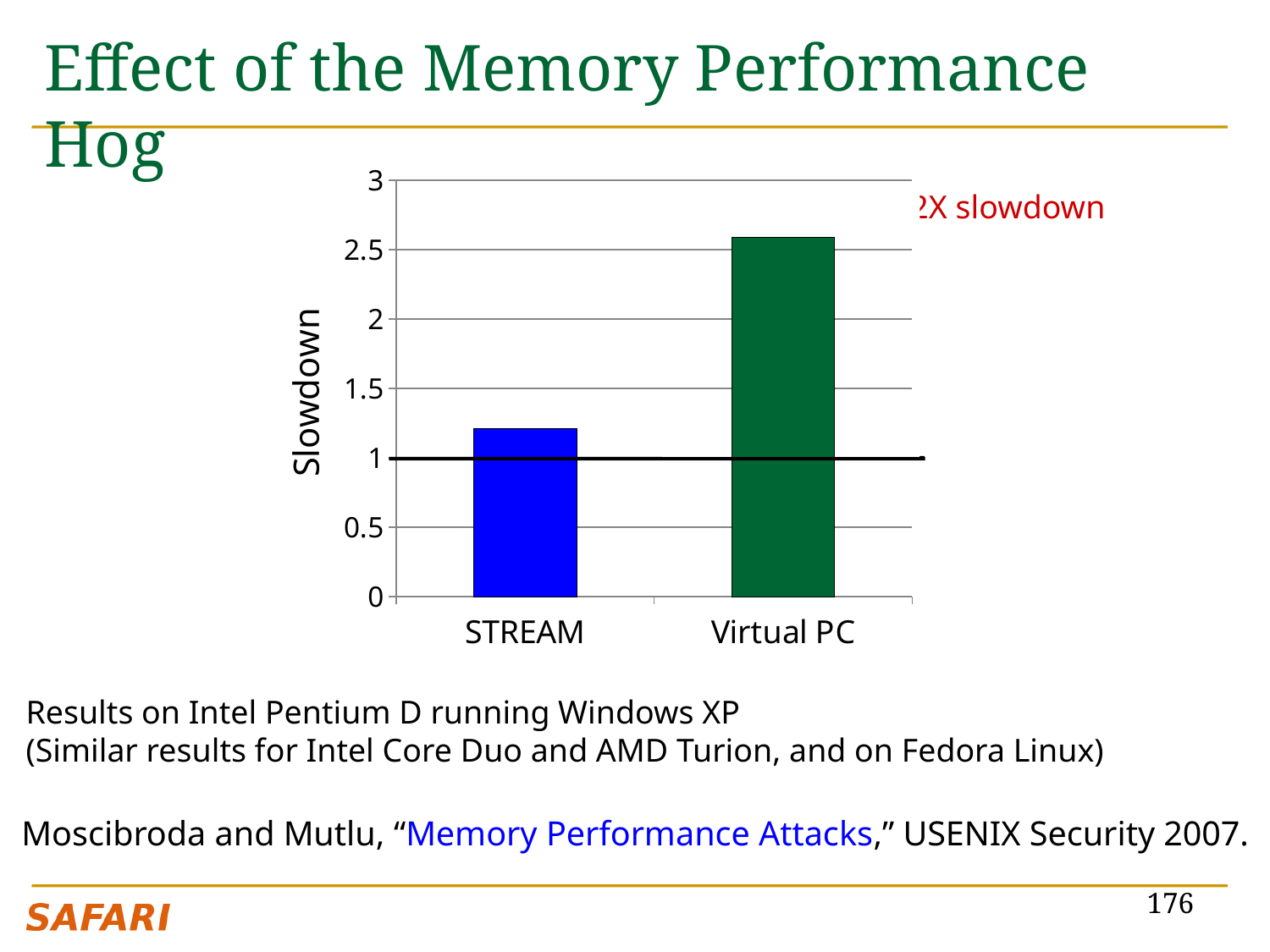
Is the slowdown for Virtual PC greater or less than 3? less What is the highest tick value shown on the vertical axis of the chart? 3 Is the slowdown for STREAM greater or less than 1? greater Which has the larger slowdown, STREAM or Virtual PC? Virtual PC Is the slowdown for STREAM greater or less than 1.5? less What kind of chart is shown on the slide? bar chart How many categories are plotted on the x axis of the chart? 2 Do the bar values rise or fall going from STREAM to Virtual PC? rise Which category has the lowest slowdown in the chart? STREAM What is the label of the vertical axis of the chart? Slowdown Which category has the highest slowdown in the chart? Virtual PC